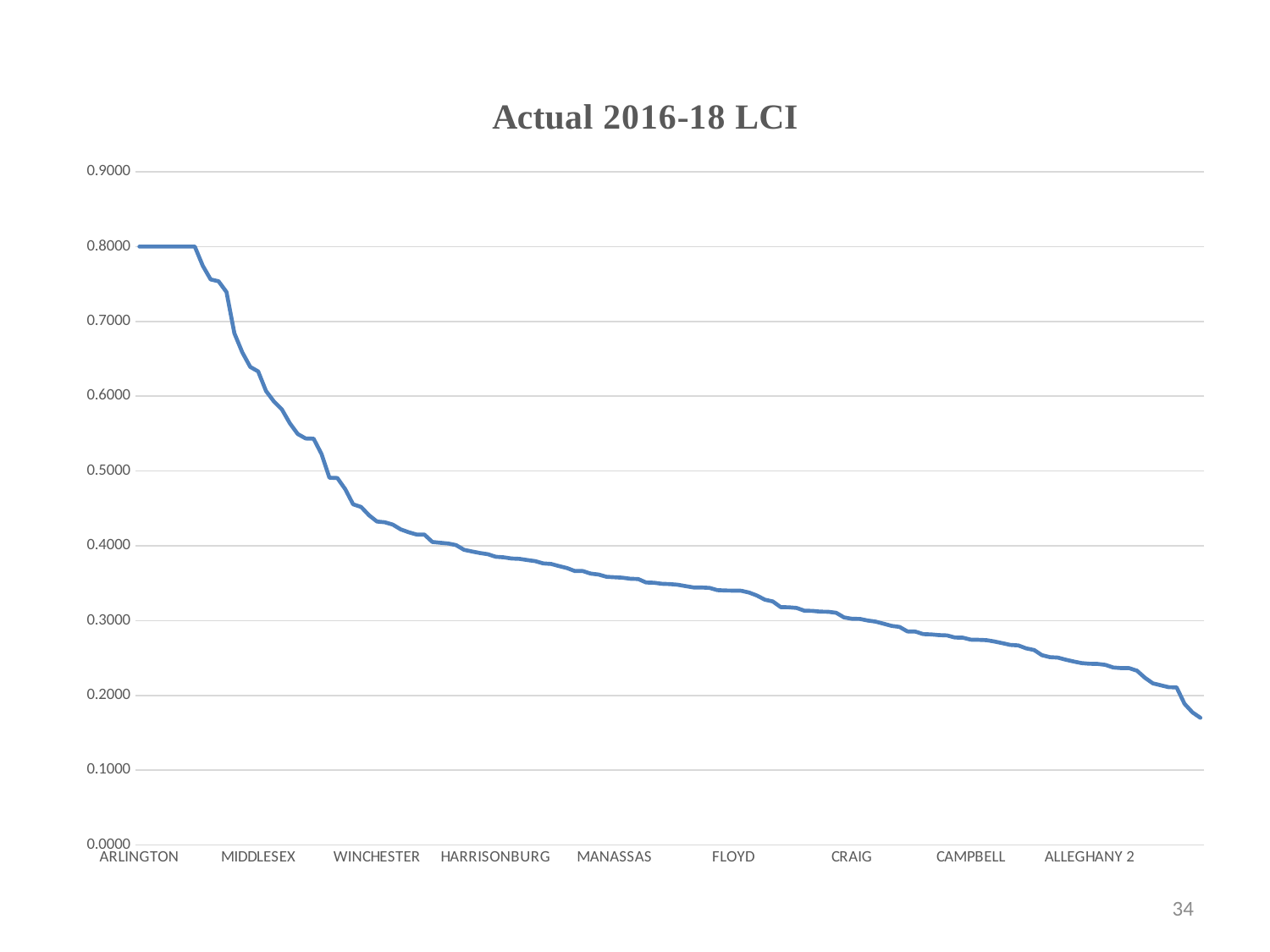
Is the value for MIDDLESEX greater or less than 0.5000? greater Do the values rise or fall moving from left to right along the x axis? fall Which has the larger value, ARLINGTON or CRAIG? ARLINGTON Is the value for ALLEGHANY 2 greater or less than 0.2000? greater What is the value for ARLINGTON? 0.8000 Is the value for CAMPBELL greater or less than 0.3000? less How many category labels are shown on the x axis? 9 What is the title of the chart? Actual 2016-18 LCI What kind of chart is shown on the slide? line chart